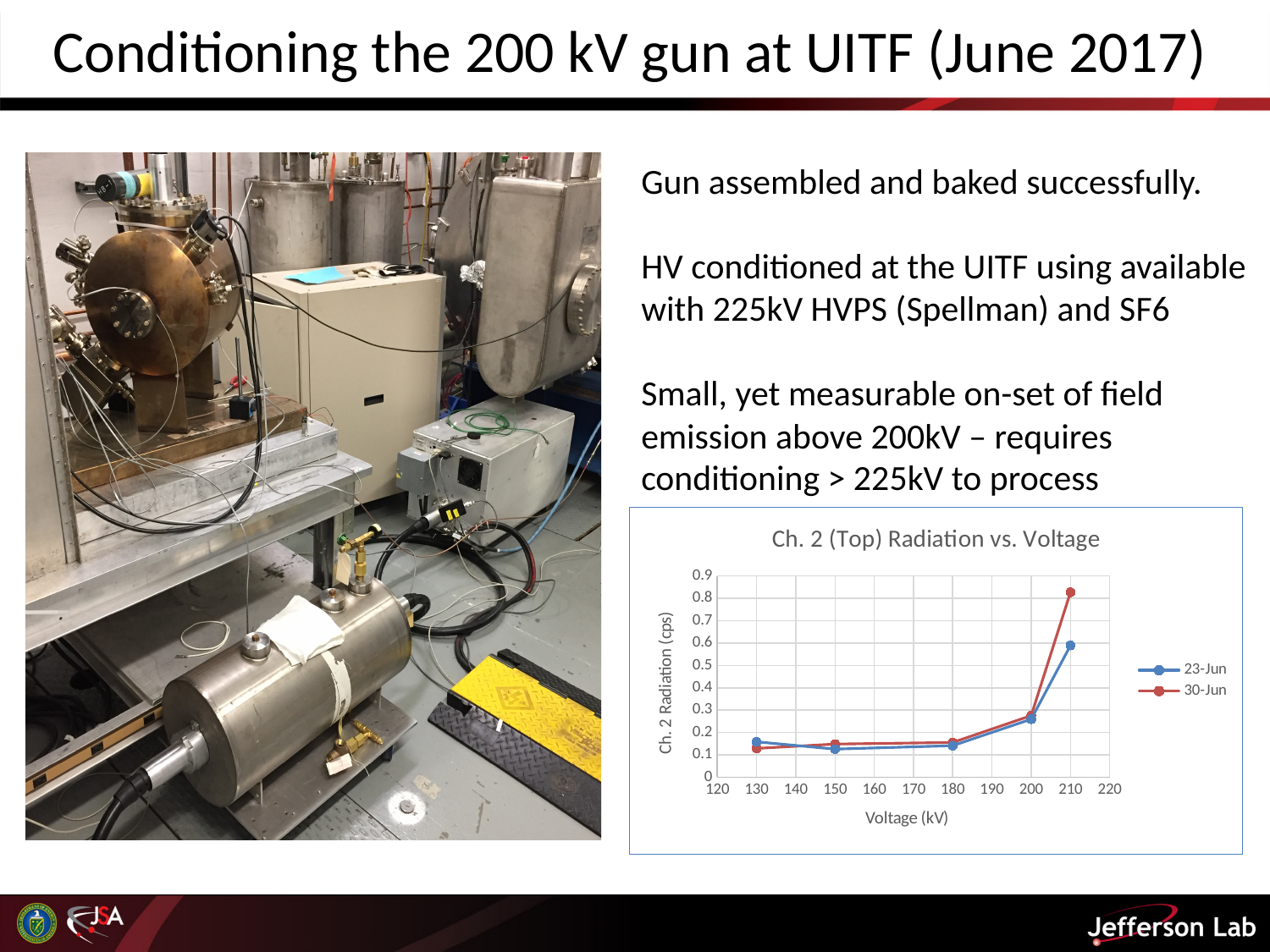
Is the 30-Jun radiation value at 150 kV greater or less than 0.3? less Is the 23-Jun radiation value at 210 kV greater or less than 0.5? greater How many series does the legend of the chart list? 2 Is the 23-Jun radiation value at 200 kV greater or less than 0.3? less At which voltage does the 30-Jun series reach its highest radiation value? 210 What is the title of the chart? Ch. 2 (Top) Radiation vs. Voltage At 210 kV, which series shows the higher radiation value, 23-Jun or 30-Jun? 30-Jun How many data points are plotted for the 30-Jun series? 5 What are the two series named in the chart legend? 23-Jun and 30-Jun Between 180 kV and 210 kV, do the radiation values rise or fall? rise What kind of chart is shown on the slide? line chart